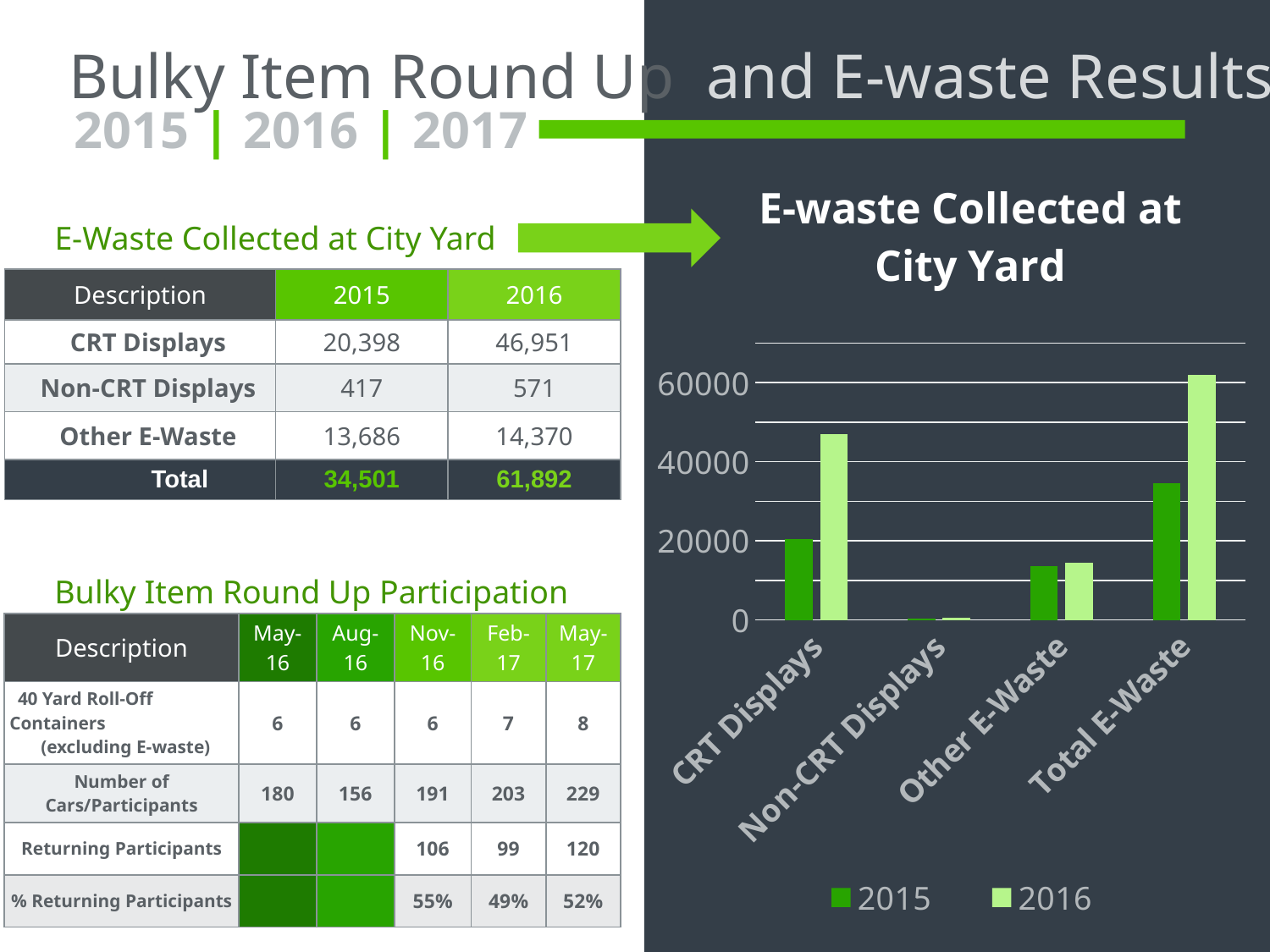
In the chart, is the 2015 value for CRT Displays greater or less than 40000? less In the chart, is the 2016 value for CRT Displays greater or less than 40000? greater Which category has the shortest bars in the chart? Non-CRT Displays Which series is shown in the lighter green colour in the chart? 2016 What kind of chart is shown on the right side of the slide? bar chart Which category has the tallest 2016 bar in the chart? Total E-Waste In the chart, is the 2015 value for Total E-Waste greater or less than 40000? less How many series does the chart legend list? 2 What is the title of the chart on the right side of the slide? E-waste Collected at City Yard In the chart, which is larger for CRT Displays: the 2015 bar or the 2016 bar? 2016 How many categories are shown on the x axis of the chart? 4